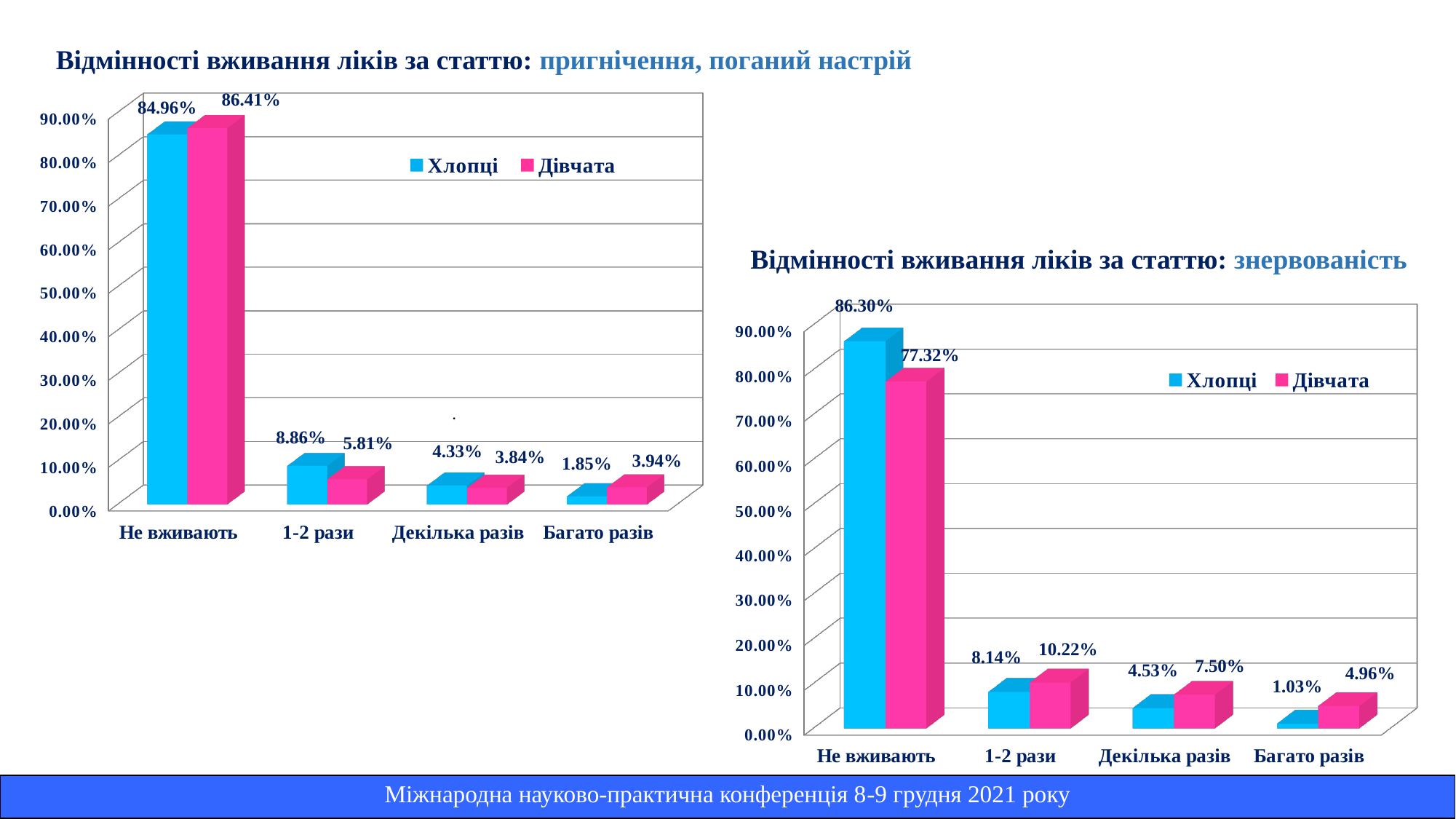
How many series does the legend of the right chart (знервованість) list? 2 In the left chart (пригнічення, поганий настрій), what is the value for Хлопці in the category Не вживають? 84.96% In the right chart (знервованість), what is the value for Хлопці in the category Багато разів? 1.03% In the right chart (знервованість), which category has the lowest value for Хлопці? Багато разів In the left chart (пригнічення, поганий настрій), which category has the highest value for Дівчата? Не вживають In the left chart (пригнічення, поганий настрій), what is the value for Дівчата in the category 1-2 рази? 5.81% In the left chart (пригнічення, поганий настрій), which is larger in the category 1-2 рази: Хлопці or Дівчата? Хлопці What type of chart is the left chart (пригнічення, поганий настрій)? Bar chart How many categories are shown on the x axis of the left chart (пригнічення, поганий настрій)? 4 In the right chart (знервованість), is the value for Дівчата in the category Не вживають greater or less than 80.00%? less In the right chart (знервованість), what is the difference between Хлопці and Дівчата in the category Не вживають? 8.98% In the right chart (знервованість), what is the value for Дівчата in the category Не вживають? 77.32%